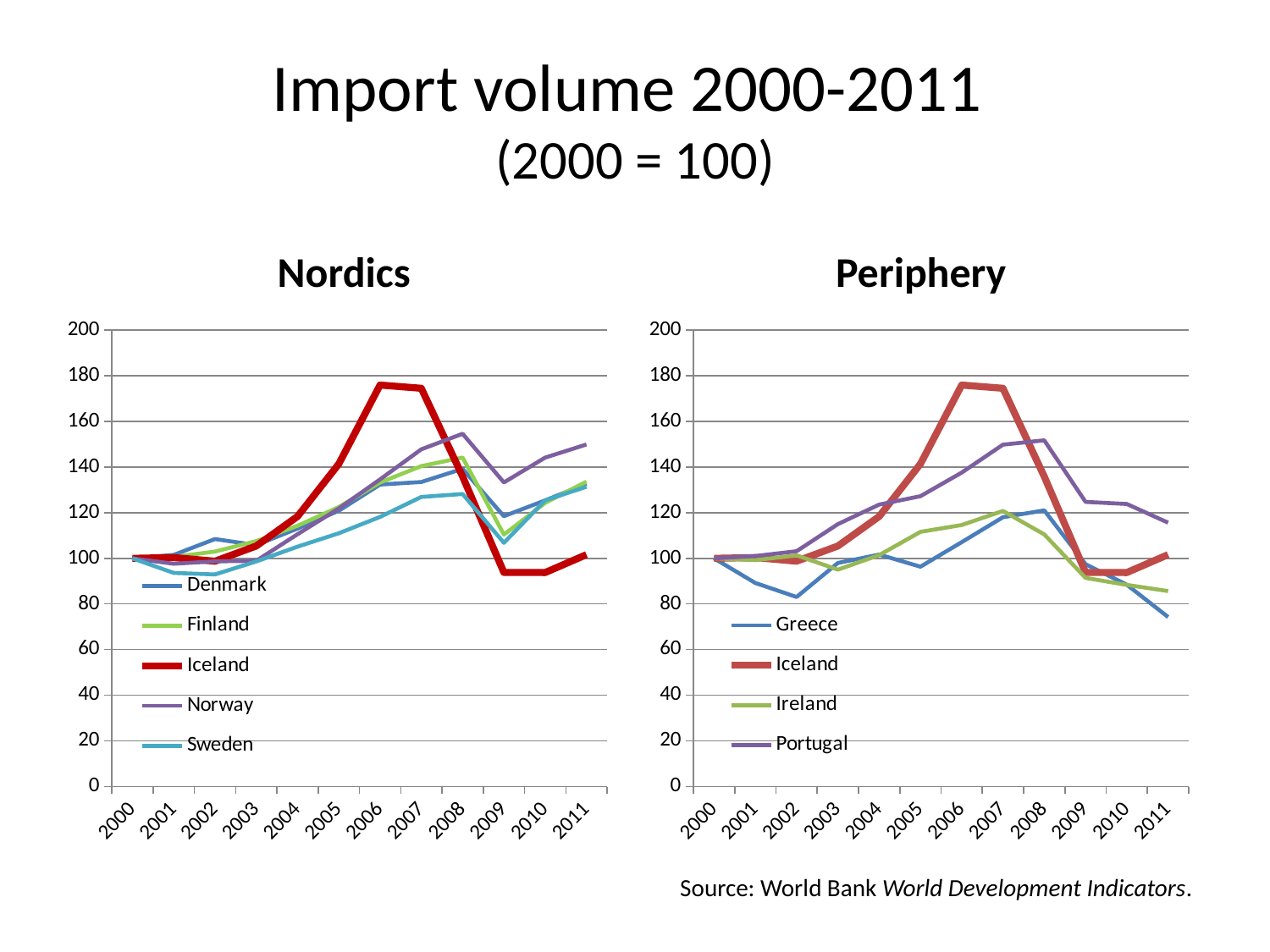
In the Nordics chart, is the value for Iceland in 2009 greater or less than 100? less How many series does the legend of the Periphery chart list? 4 In the Periphery chart, which is larger in 2008, Portugal or Greece? Portugal How many series does the legend of the Nordics chart list? 5 In the Periphery chart, is the value for Greece in 2011 greater or less than 80? less In the Nordics chart, does the value for Norway rise or fall from 2000 to 2008? rise What kind of chart is the Nordics chart? line chart In the Periphery chart, which series has the lowest value in 2011? Greece How many years are shown on the x axis of the Periphery chart? 12 In the Nordics chart, is the value for Iceland in 2006 greater or less than 160? greater In the Nordics chart, which series has the highest value in 2006? Iceland In the Nordics chart, what is the value for Denmark in 2000? 100